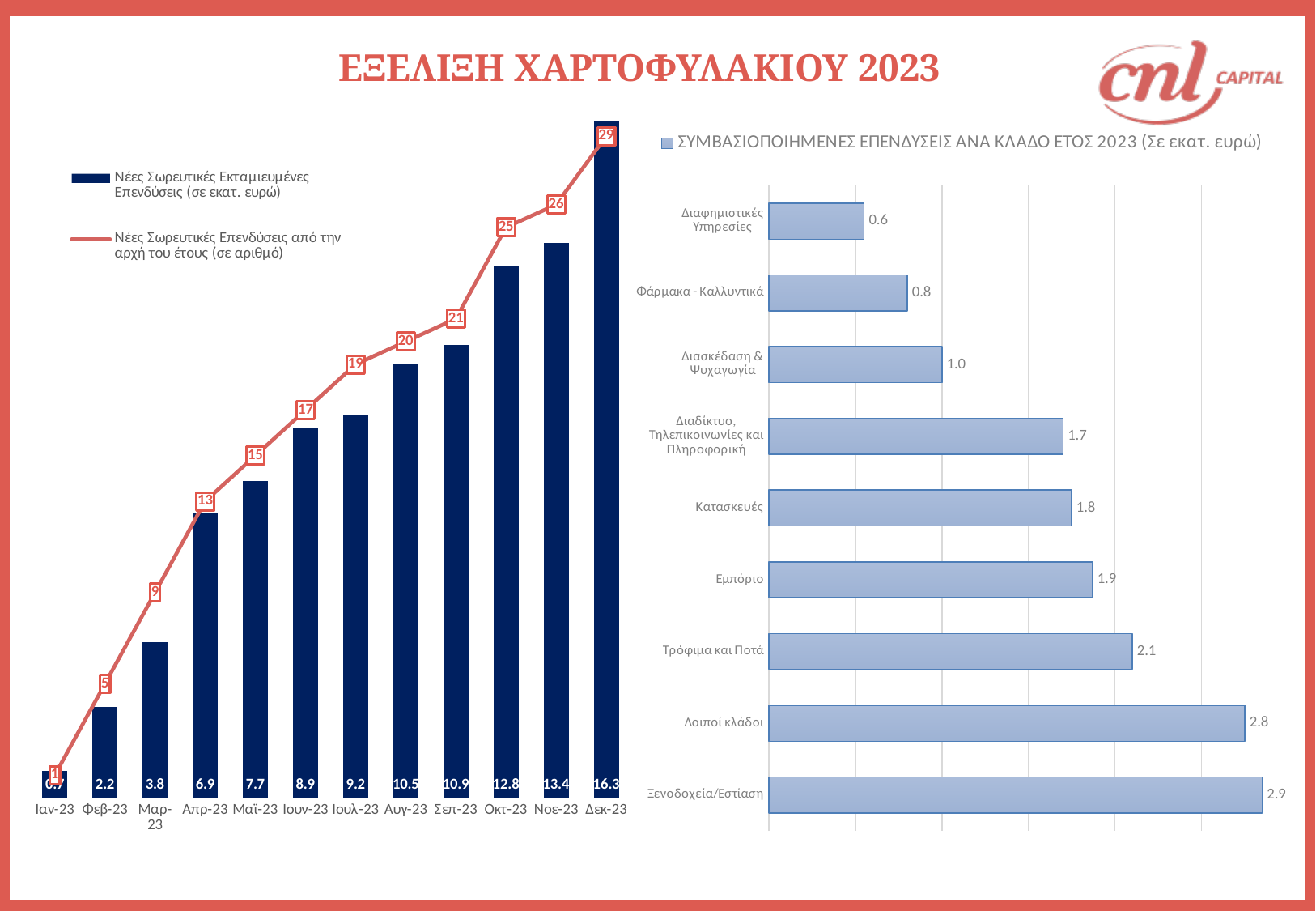
In the right chart, which category has the highest value? Ξενοδοχεία/Εστίαση In the left chart, what value does the line show for Ιουν-23? 17 In the right chart, which category has the lowest value? Διαφημιστικές Υπηρεσίες What kind of chart is the right chart? bar chart In the left chart, how many months are shown on the x axis? 12 In the right chart, what is the difference between Λοιποί κλάδοι and Τρόφιμα και Ποτά? 0.7 In the left chart, what is the value of the bar for Δεκ-23? 16.3 In the right chart, how many categories are shown? 9 In the left chart, do the bar values rise or fall from Ιαν-23 to Δεκ-23? rise In the left chart, what is the difference between the bar values for Δεκ-23 and Νοε-23? 2.9 In the right chart, what is the value for Κατασκευές? 1.8 In the left chart, how many series does the legend list? 2